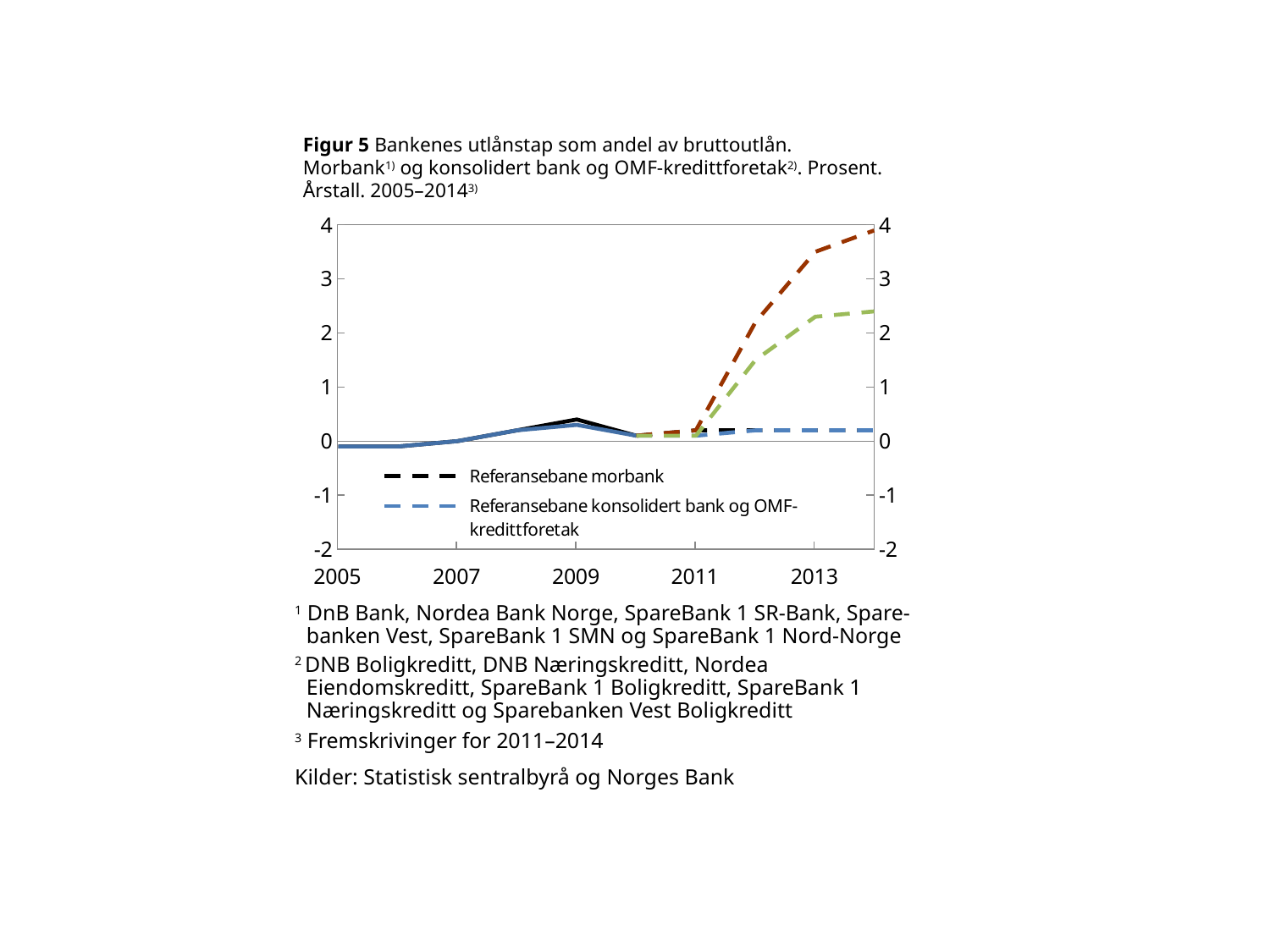
Is the value of the red dashed line at the end of the series (2014) greater or less than 3? greater Is the value of the green dashed line at the end of the series (2014) greater or less than 2? greater What is the title of the chart (Figur 5)? Bankenes utlånstap som andel av bruttoutlån What kind of chart is shown on the slide? line chart Does the red dashed line rise or fall from 2011 to 2014? rise Is the value of the 'Referansebane morbank' line in 2013 greater or less than 1? less Which is higher in 2013, the red dashed line or the green dashed line? the red dashed line What is the first entry in the chart's legend? Referansebane morbank How many series does the legend list? 2 What is the highest value shown on the vertical axis? 4